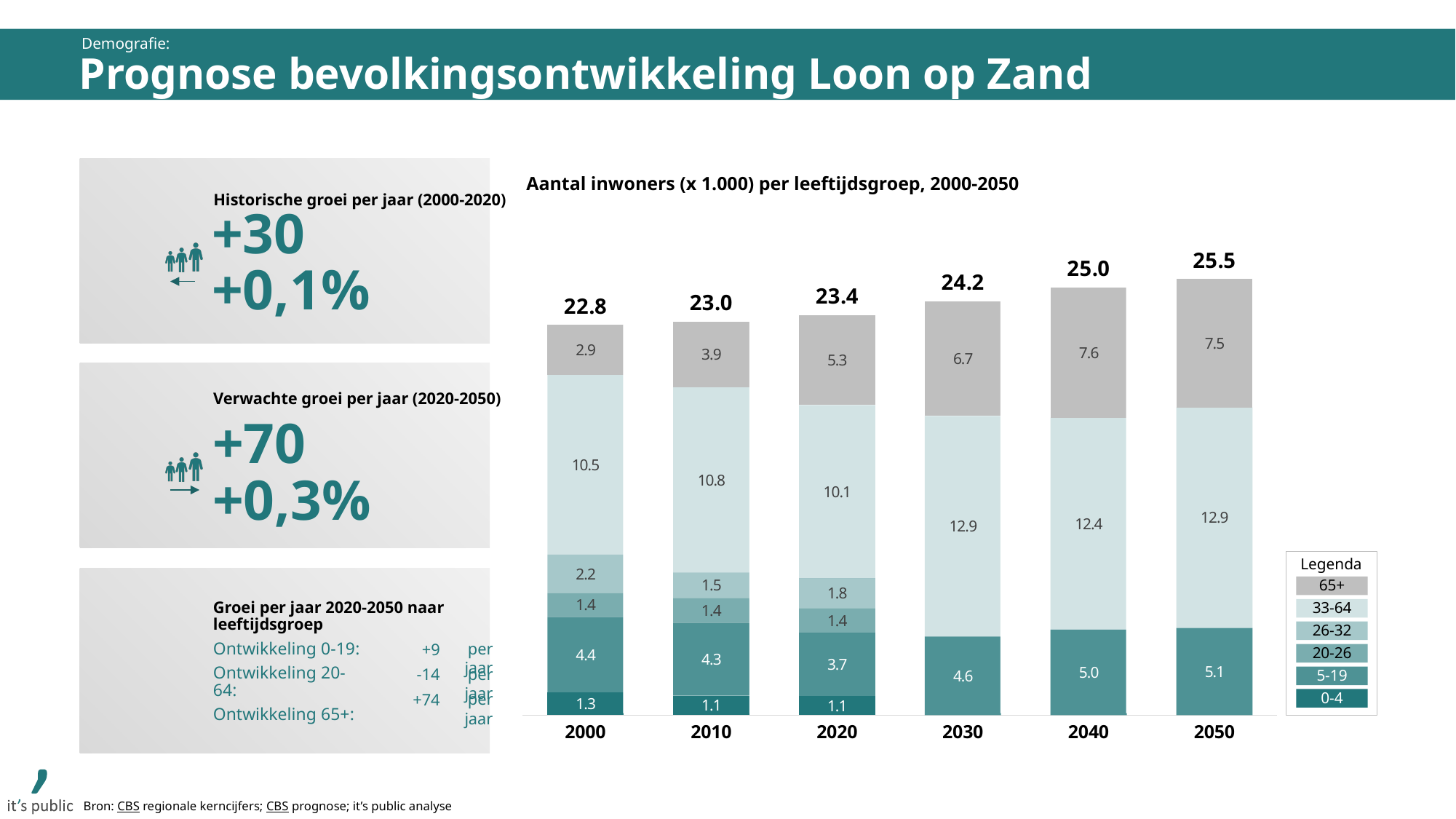
What kind of chart is shown on the slide? stacked bar chart What is the difference between the 65+ value in 2040 and the 65+ value in 2000? 4.7 How many series does the legend of the chart list? 6 Do the total values rise or fall from 2000 to 2050? rise What is the value for the 0-4 age group in 2000? 1.3 Which year has the lowest total number of inhabitants? 2000 How many years are shown on the x axis of the chart? 6 Which year has the highest total number of inhabitants? 2050 What is the value for the 33-64 age group in 2010? 10.8 Which is larger: the 5-19 value in 2000 or the 5-19 value in 2020? 2000 What is the value for the 65+ age group in 2020? 5.3 What is the total number of inhabitants (x 1.000) shown for 2050? 25.5